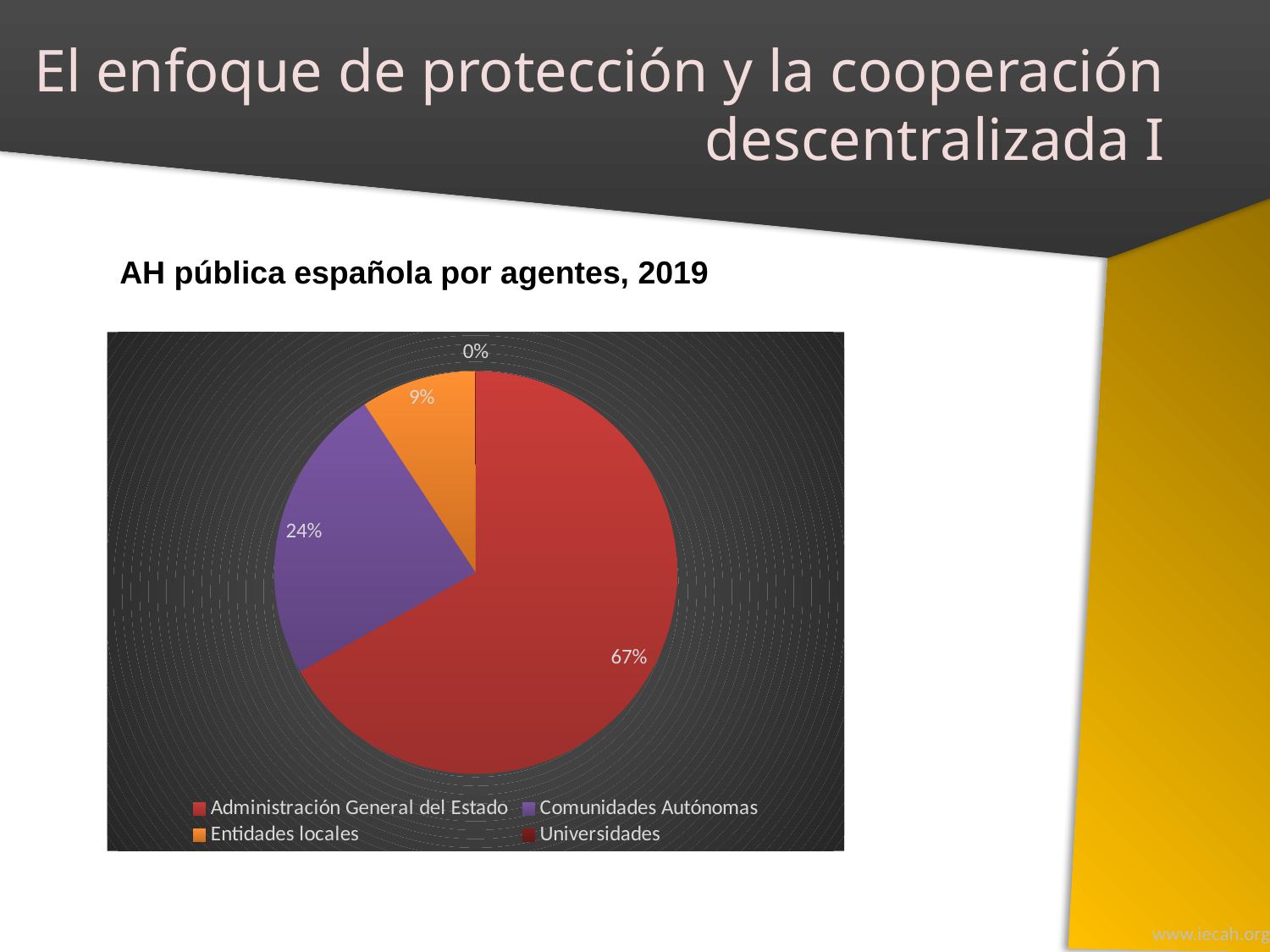
Which category has the largest slice of the pie? Administración General del Estado What share of the pie does Entidades locales hold? 9% Which is larger, the share for Comunidades Autónomas or the share for Entidades locales? Comunidades Autónomas What share of the pie does Universidades hold? 0% What share of the pie does Comunidades Autónomas hold? 24% What kind of chart is shown on the slide? pie chart Which category has the smallest slice of the pie? Universidades How many categories does the legend list? 4 What colour is the slice for Comunidades Autónomas? purple What is the title of the chart? AH pública española por agentes, 2019 What is the difference in percentage points between Administración General del Estado and Comunidades Autónomas? 43